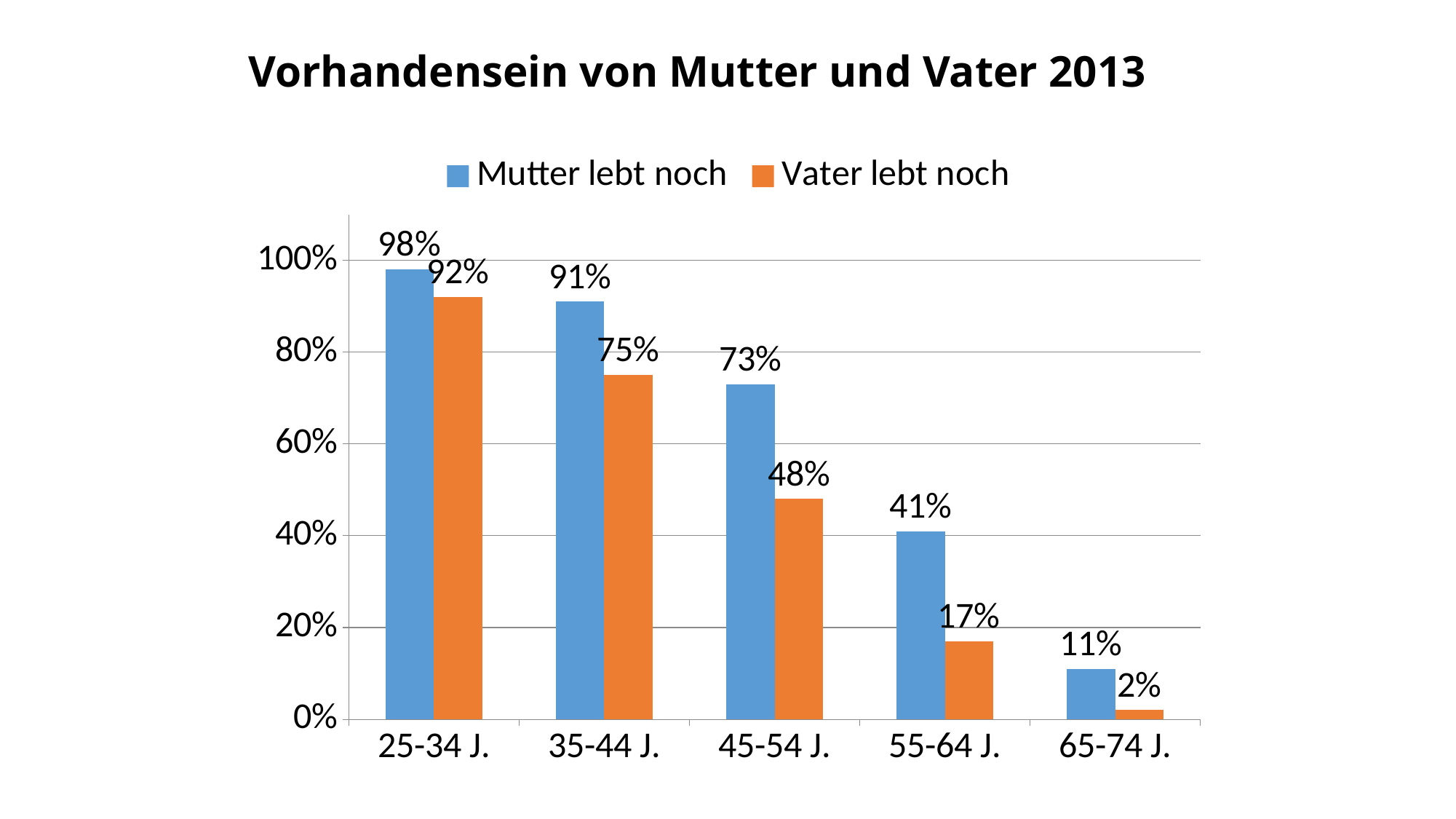
Which is larger in the 35-44 J. age group: "Mutter lebt noch" or "Vater lebt noch"? Mutter lebt noch What kind of chart is shown on the slide? Bar chart What is the value for "Vater lebt noch" in the 25-34 J. age group? 92% What is the value for "Mutter lebt noch" in the 45-54 J. age group? 73% Do the values for "Mutter lebt noch" rise or fall across the age groups from left to right? Fall Which age group has the lowest value for "Vater lebt noch"? 65-74 J. How many age groups are shown on the x axis? 5 How many series does the legend list? 2 Is the value for "Vater lebt noch" in the 55-64 J. age group greater or less than 20%? less What is the value for "Vater lebt noch" in the 55-64 J. age group? 17% Which age group has the highest value for "Mutter lebt noch"? 25-34 J. What is the difference between "Mutter lebt noch" and "Vater lebt noch" in the 45-54 J. age group? 25%